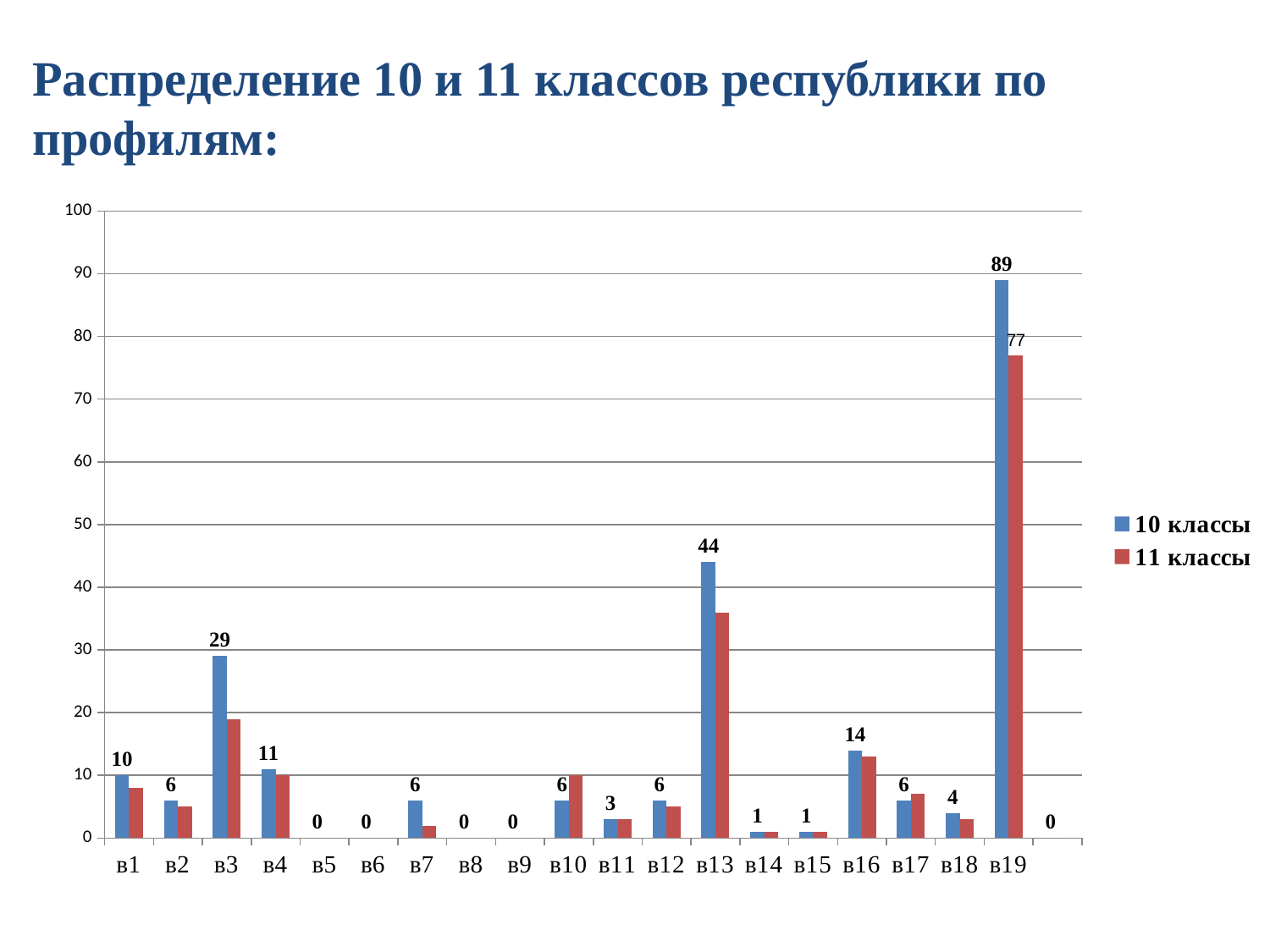
What is the value for в19 in the 11 классы series? 77 How many series does the legend list? 2 Is the value for в13 in the 11 классы series greater or less than 30? greater What are the two entries in the chart legend? 10 классы and 11 классы Is the value for в1 in the 11 классы series greater or less than 10? less What is the value for в3 in the 10 классы series? 29 What kind of chart is shown on the slide? bar chart What is the difference between the 10 классы and 11 классы values for в19? 12 Which category has the highest value in the 10 классы series? в19 What is the value for в13 in the 10 классы series? 44 What is the value for в19 in the 10 классы series? 89 Which is larger in the 10 классы series: в3 or в13? в13